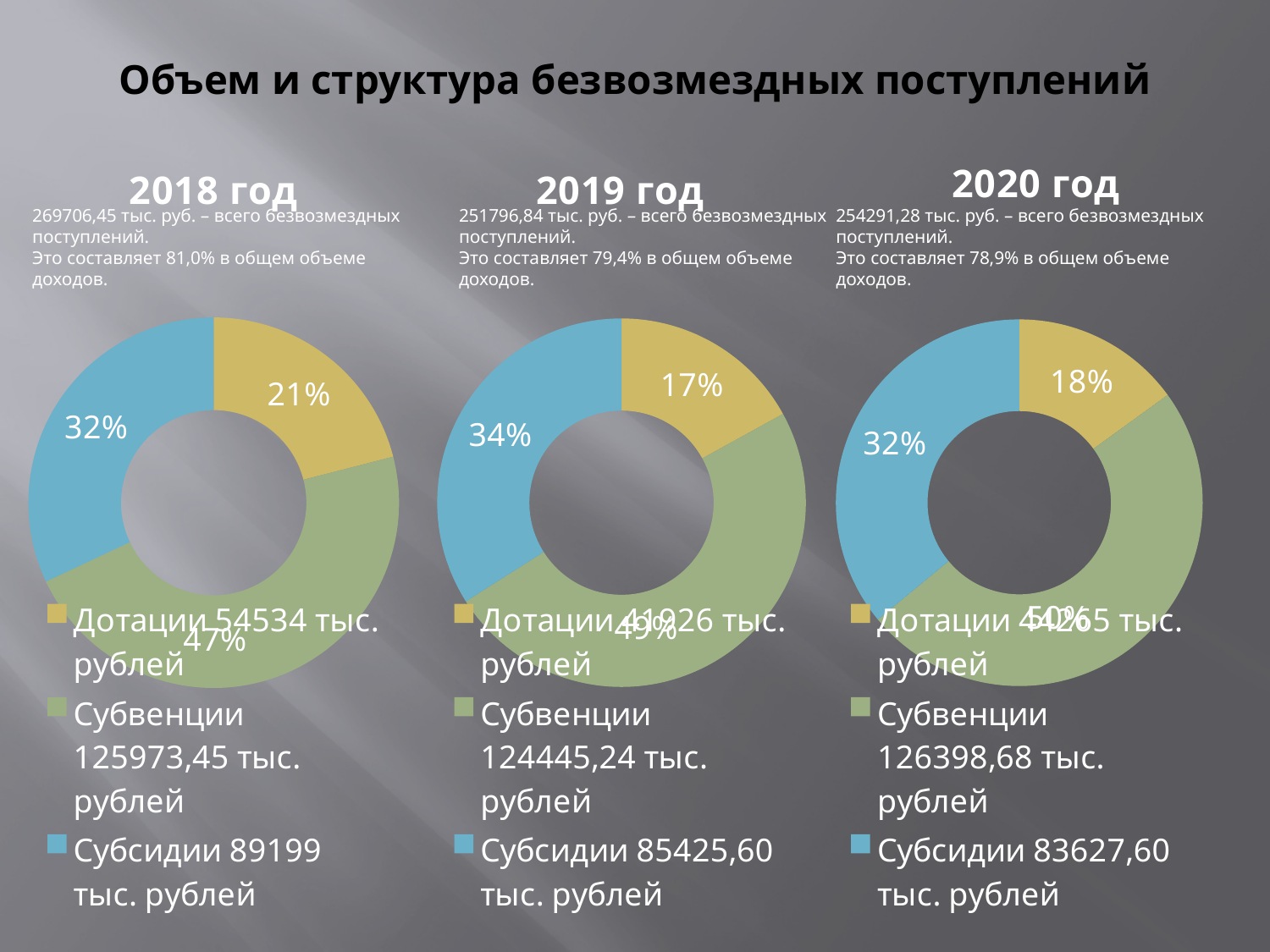
In the 2018 год chart, which is larger: the share for Субсидии or the share for Дотации? Субсидии In the 2019 год chart, which category has the smallest slice? Дотации In the 2020 год chart, what percentage is shown for Субсидии? 32% In the 2018 год chart, which category has the largest slice? Субвенции In the 2019 год chart, what percentage is shown for Субсидии? 34% In the 2018 год chart, what is the difference in percentage points between the Субсидии share and the Дотации share? 11 percentage points In the 2019 год chart, what percentage is shown for Дотации? 17% In the 2018 год chart, what percentage is shown for Субсидии? 32% What type of chart is used for each year on the slide? Doughnut (pie) chart How many categories does the legend of the 2020 год chart list? 3 In the 2020 год chart, what percentage is shown for Дотации? 18% In the 2018 год chart, what percentage is shown for Дотации? 21%